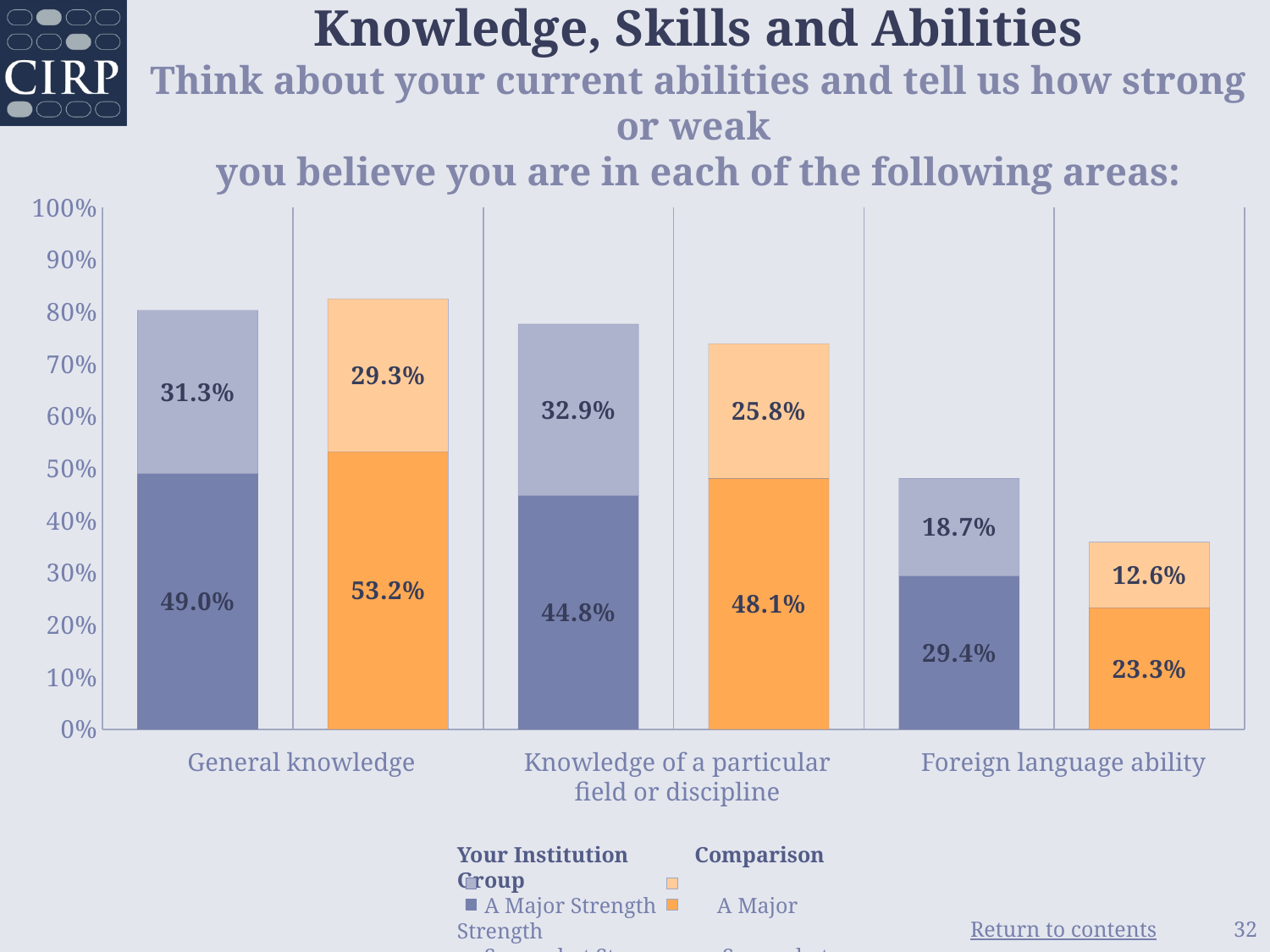
What percentage of Your Institution respondents rated General knowledge as 'A Major Strength'? 49.0% What type of chart is shown on the slide? stacked bar chart What percentage of the Comparison Group rated Foreign language ability as 'A Major Strength'? 23.3% Which category has the highest 'A Major Strength' value for the Comparison Group? General knowledge What is the total height of the Your Institution stacked bar for Foreign language ability? 48.1% For General knowledge, which is larger for 'A Major Strength': Your Institution or the Comparison Group? Comparison Group Is the total of the Comparison Group bar for Foreign language ability greater or less than 40%? less How many categories are shown on the x axis? 3 Which category has the lowest 'A Major Strength' value for Your Institution? Foreign language ability What is the total height of the Comparison Group stacked bar for General knowledge? 82.5% What is the difference between the 'A Major Strength' values for Your Institution and the Comparison Group in Foreign language ability? 6.1% What is the value of the upper (lighter) segment of the Comparison Group bar for Knowledge of a particular field or discipline? 25.8%